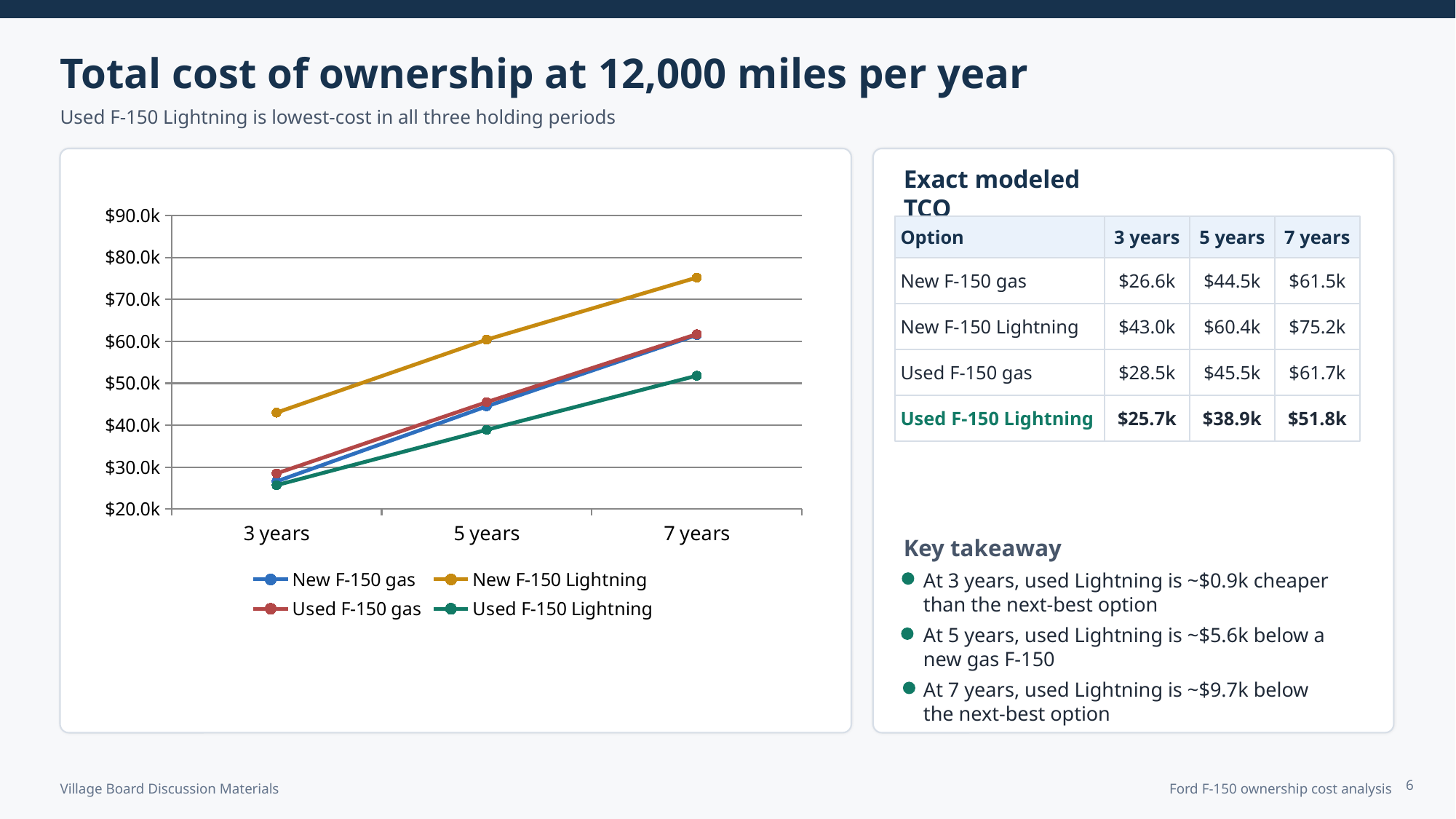
According to the Exact modeled TCO table, what is the 7-year total cost of ownership for New F-150 gas? $61.5k What kind of chart is shown on the slide? line chart According to the Exact modeled TCO table, what is the 5-year total cost of ownership for Used F-150 Lightning? $38.9k Using the Exact modeled TCO table, what is the difference between the 7-year cost of New F-150 Lightning and Used F-150 Lightning? $23.4k How many holding periods are plotted along the x axis of the chart? 3 Do the total cost of ownership values rise or fall as the holding period increases from 3 years to 7 years? rise Is the value for New F-150 Lightning at 3 years greater or less than $40.0k? greater Is the value for Used F-150 Lightning at 7 years greater or less than $60.0k? less How many series does the chart legend list? 4 Which is larger at 5 years: the cost for New F-150 Lightning or the cost for Used F-150 gas? New F-150 Lightning Which option has the lowest total cost of ownership at 5 years? Used F-150 Lightning Which option has the highest total cost of ownership at 7 years? New F-150 Lightning